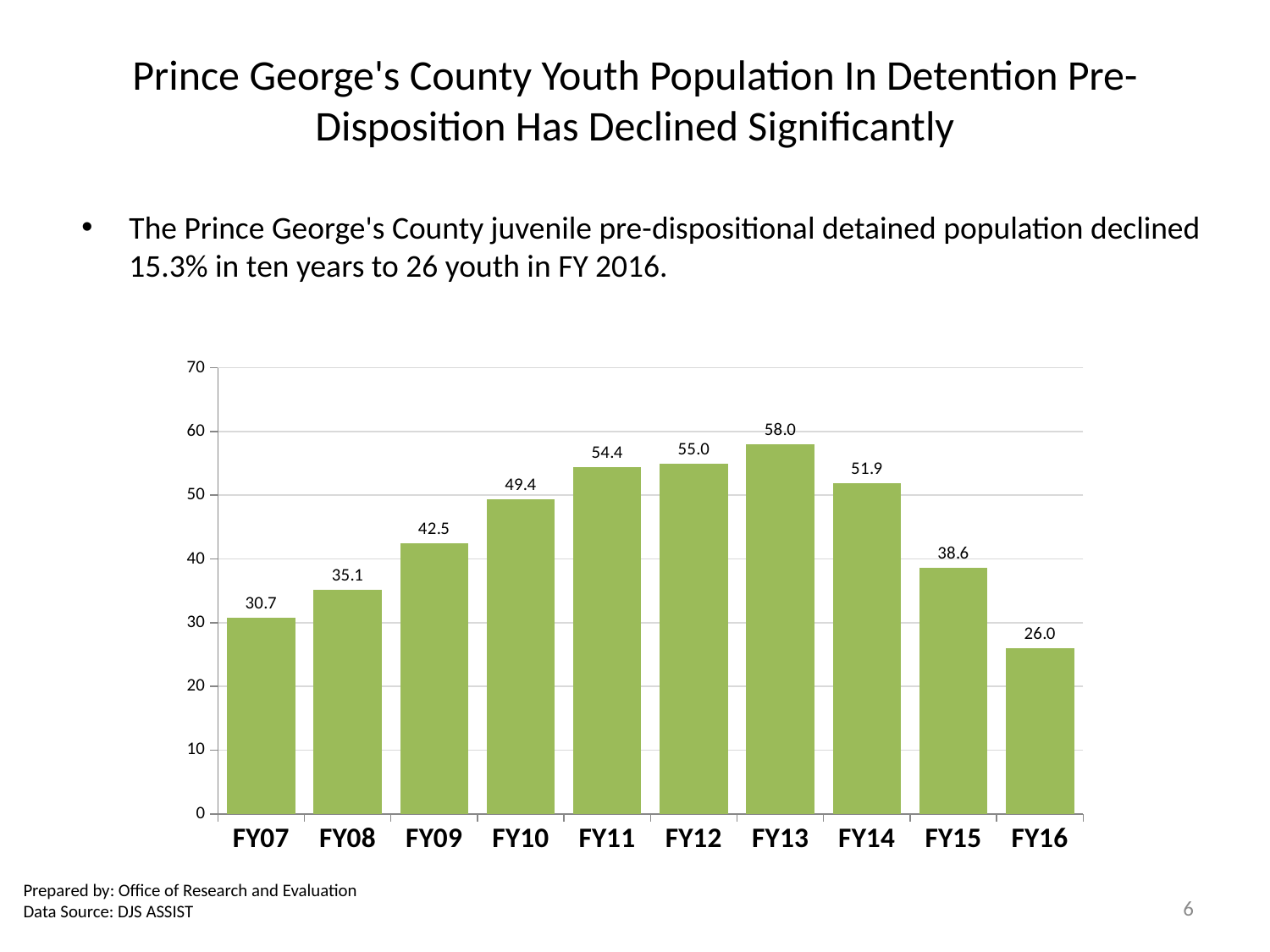
What is the value for FY07? 30.7 What is the value for FY13? 58.0 How many fiscal years are shown on the x axis? 10 Do the values rise or fall from FY13 to FY16? fall What is the difference between the values for FY13 and FY16? 32.0 Which is larger, the value for FY10 or the value for FY14? FY14 Is the value for FY09 greater or less than 40? greater Which fiscal year has the lowest value? FY16 What is the value for FY16? 26.0 Which fiscal year has the highest value? FY13 What is the difference between the values for FY14 and FY15? 13.3 What kind of chart is shown on the slide? bar chart